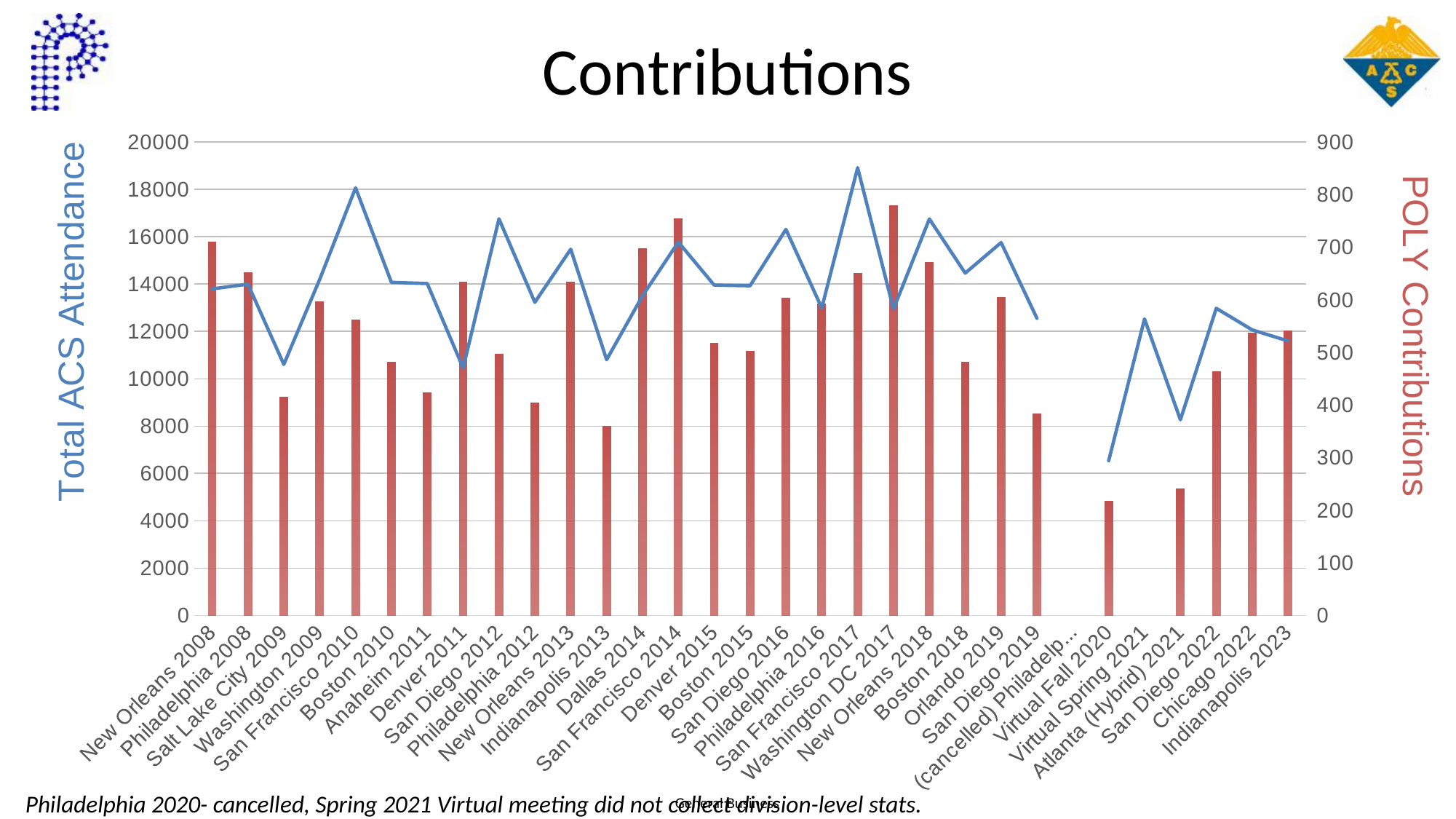
Which meeting has the lowest Total ACS Attendance on the line? Virtual Fall 2020 What is the title of the chart? Contributions Is the Total ACS Attendance for San Francisco 2010 greater or less than 16000? greater Is the POLY Contributions value for Washington DC 2017 greater or less than 700? greater Is the Total ACS Attendance for Virtual Fall 2020 greater or less than 8000? less What kind of chart is shown on the slide? Combined bar and line chart Which has the larger POLY Contributions bar, New Orleans 2008 or Philadelphia 2008? New Orleans 2008 Do the POLY Contributions bars rise or fall from Virtual Fall 2020 to Indianapolis 2023? rise What is the title of the left vertical axis? Total ACS Attendance Which meeting has the highest Total ACS Attendance on the line? San Francisco 2017 Which meeting has the highest POLY Contributions bar? Washington DC 2017